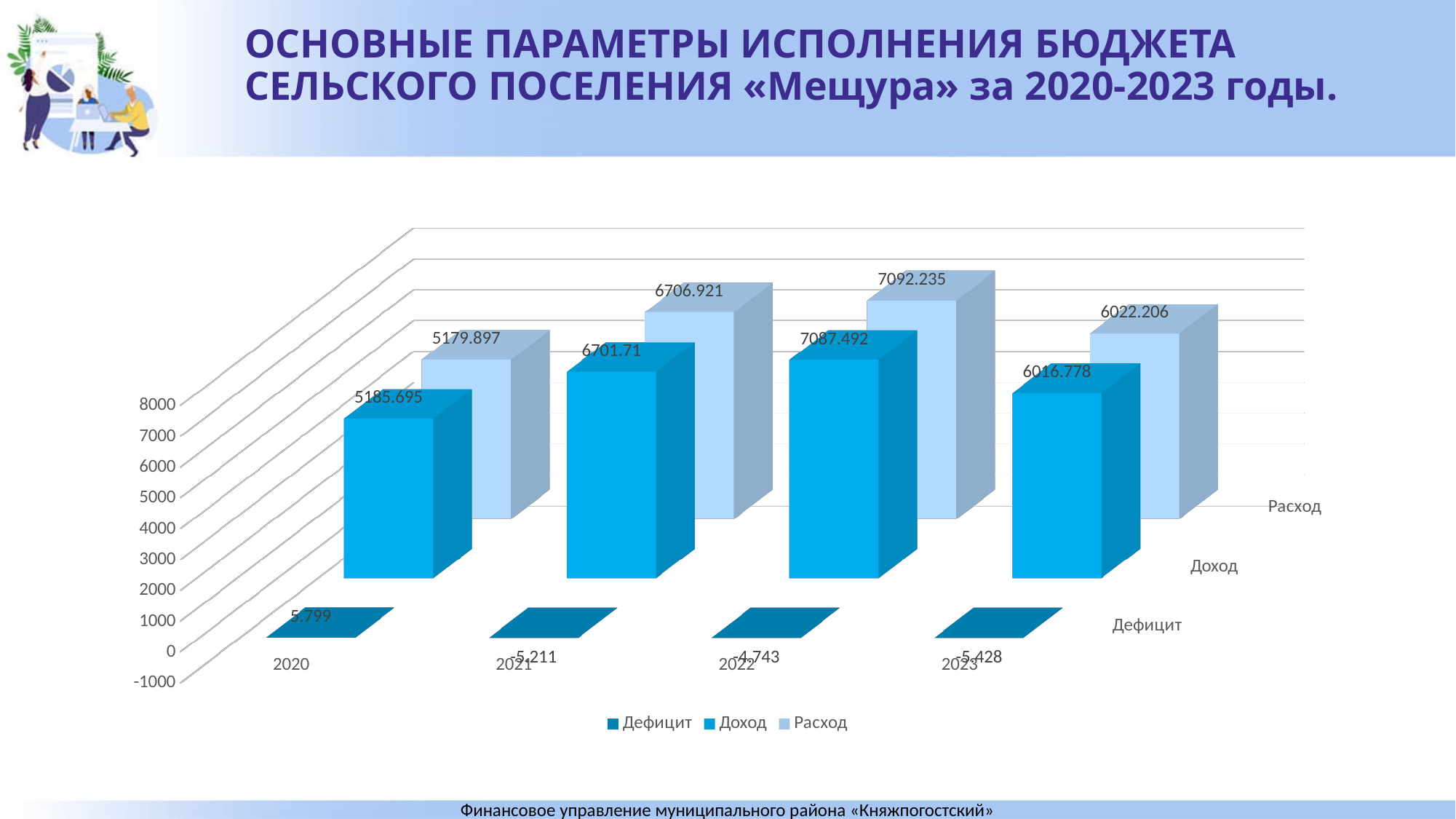
How many years are shown on the x axis? 4 What is the value of Дефицит for 2020? 5.799 Is the value of Доход for 2023 greater or less than 5000? greater What is the difference between Расход and Доход in 2022? 4.743 How many series does the legend list? 3 Which is larger in 2021, Доход or Расход? Расход Does Доход rise or fall from 2020 to 2022? rise What kind of chart is shown on the slide? bar chart What is the value of Доход for 2022? 7087.492 What is the value of Расход for 2020? 5179.897 In which year is Доход the highest? 2022 In which year is Расход the lowest? 2020